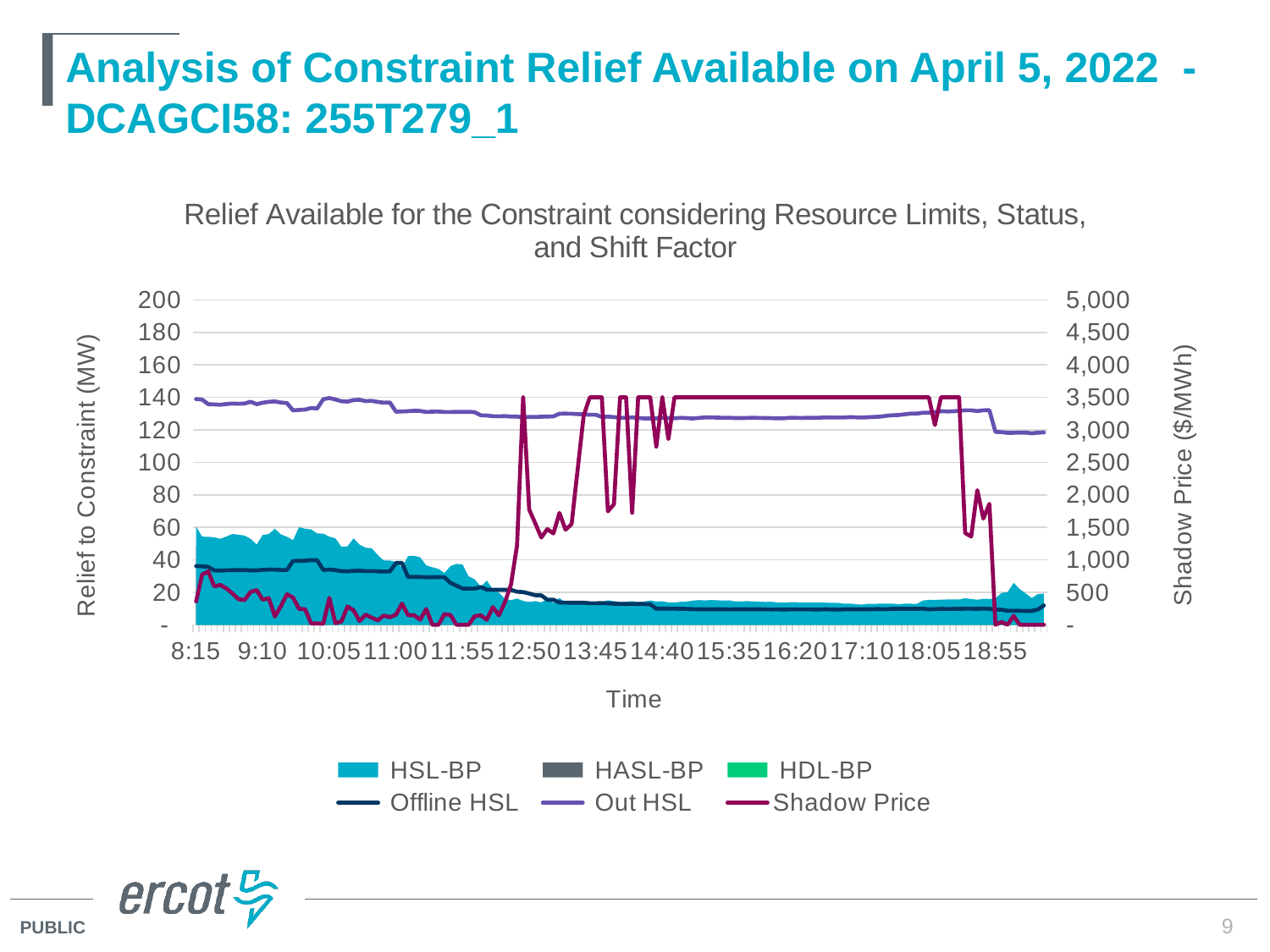
What is the title of the right-hand vertical axis? Shadow Price ($/MWh) Which is larger at 12:50, the Out HSL value or the HSL-BP value? Out HSL Does the Out HSL series rise or fall overall from 8:15 to 18:55? fall Is the Shadow Price at 16:20 greater or less than 3,000? greater Is the Offline HSL value at 8:15 greater or less than 20? greater What is the title of the chart? Relief Available for the Constraint considering Resource Limits, Status, and Shift Factor Is the HSL-BP value at 16:20 greater or less than 20? less How many series does the legend list? 6 What kind of chart is shown on the slide? Area and line chart Is the Shadow Price higher at 16:20 or at 9:10? 16:20